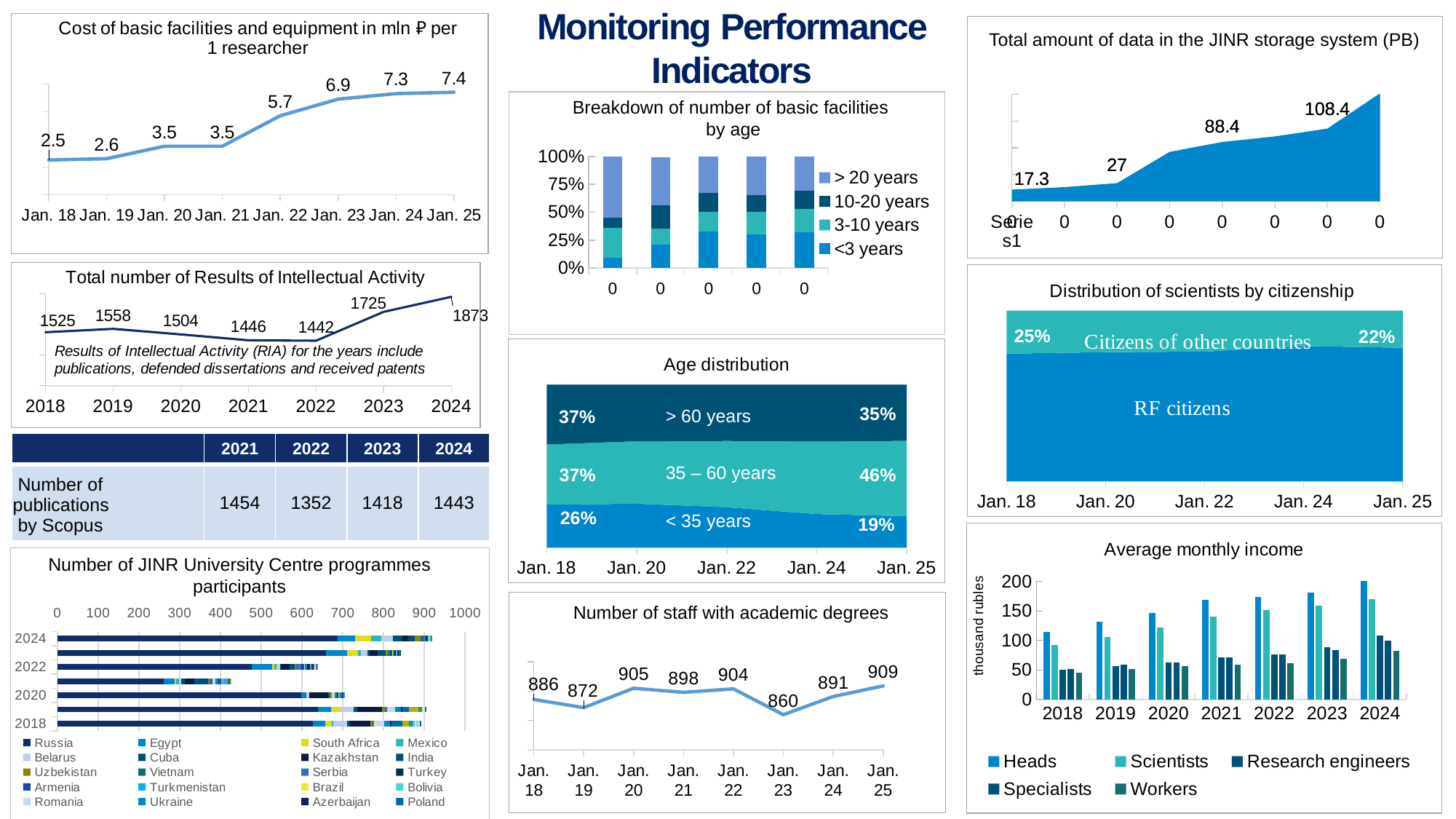
In the chart 'Distribution of scientists by citizenship', what share is shown for 'Citizens of other countries' at Jan. 25? 22% In the chart 'Number of staff with academic degrees', which point has the lowest value? Jan. 23 In the chart 'Total number of Results of Intellectual Activity', which year has the lowest value? 2022 In the chart 'Age distribution', what share is shown for '> 60 years' at Jan. 25? 35% In the chart 'Number of staff with academic degrees', what is the value for Jan. 20? 905 In the chart 'Total amount of data in the JINR storage system (PB)', what is the largest data label shown? 108.4 In the chart 'Average monthly income', is the value for Heads in 2024 greater or less than 150? greater In the chart 'Total number of Results of Intellectual Activity', what is the value for 2023? 1725 In the chart 'Cost of basic facilities and equipment in mln ₽ per 1 researcher', what is the value for Jan. 22? 5.7 In the chart 'Breakdown of number of basic facilities by age', how many series does the legend list? 4 In the chart 'Cost of basic facilities and equipment in mln ₽ per 1 researcher', what is the difference between the values for Jan. 25 and Jan. 18? 4.9 In the chart 'Average monthly income', how many series does the legend list? 5